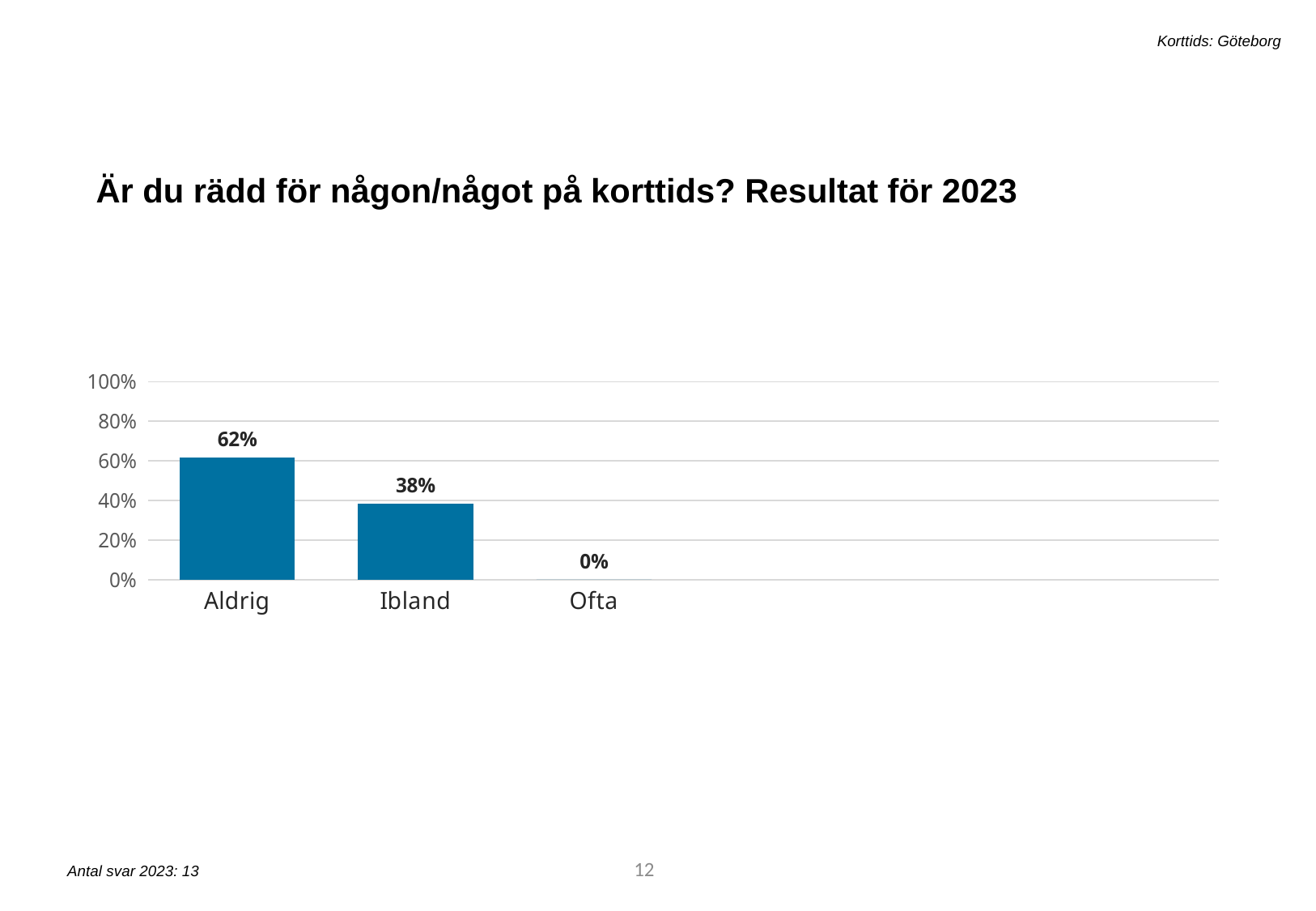
What is the value for Ibland? 38% What kind of chart is shown on the slide? bar chart Which category has the highest value? Aldrig Is the value for Ibland greater or less than 40%? less What is the value for Ofta? 0% What is the value for Aldrig? 62% Which is larger, the value for Aldrig or the value for Ibland? Aldrig Do the values rise or fall from left to right along the x axis? fall How many categories are shown on the x axis? 3 What is the title of the slide above the chart? Är du rädd för någon/något på korttids? Resultat för 2023 Which category has the lowest value? Ofta What is the difference between the values for Aldrig and Ibland? 24%